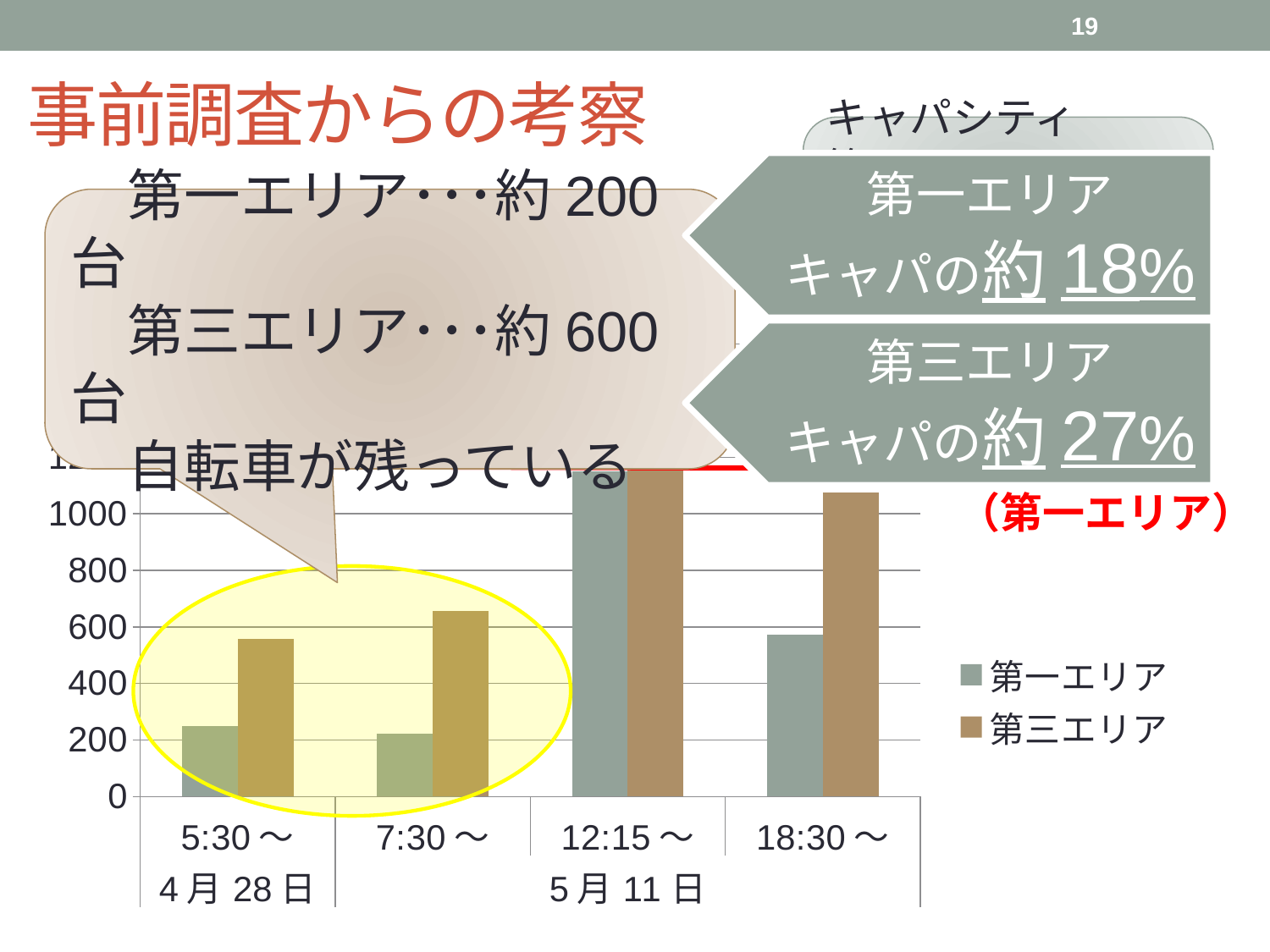
Is the value for 第三エリア at 7:30～ greater or less than 600? greater How many series does the chart legend list? 2 Is the value for 第一エリア at 5:30～ greater or less than 200? greater How many time categories are shown on the x axis of the chart? 4 Does the 第三エリア value rise or fall from 5:30～ to 12:15～? rise At 18:30～, which series has the larger value, 第一エリア or 第三エリア? 第三エリア Is the value for 第三エリア at 18:30～ greater or less than 1000? greater At which time category is the 第三エリア value highest? 12:15～ Which two series are listed in the chart legend? 第一エリア and 第三エリア What kind of chart is shown on the slide? bar chart For 第一エリア, which is larger, the value at 12:15～ or the value at 18:30～? 12:15～